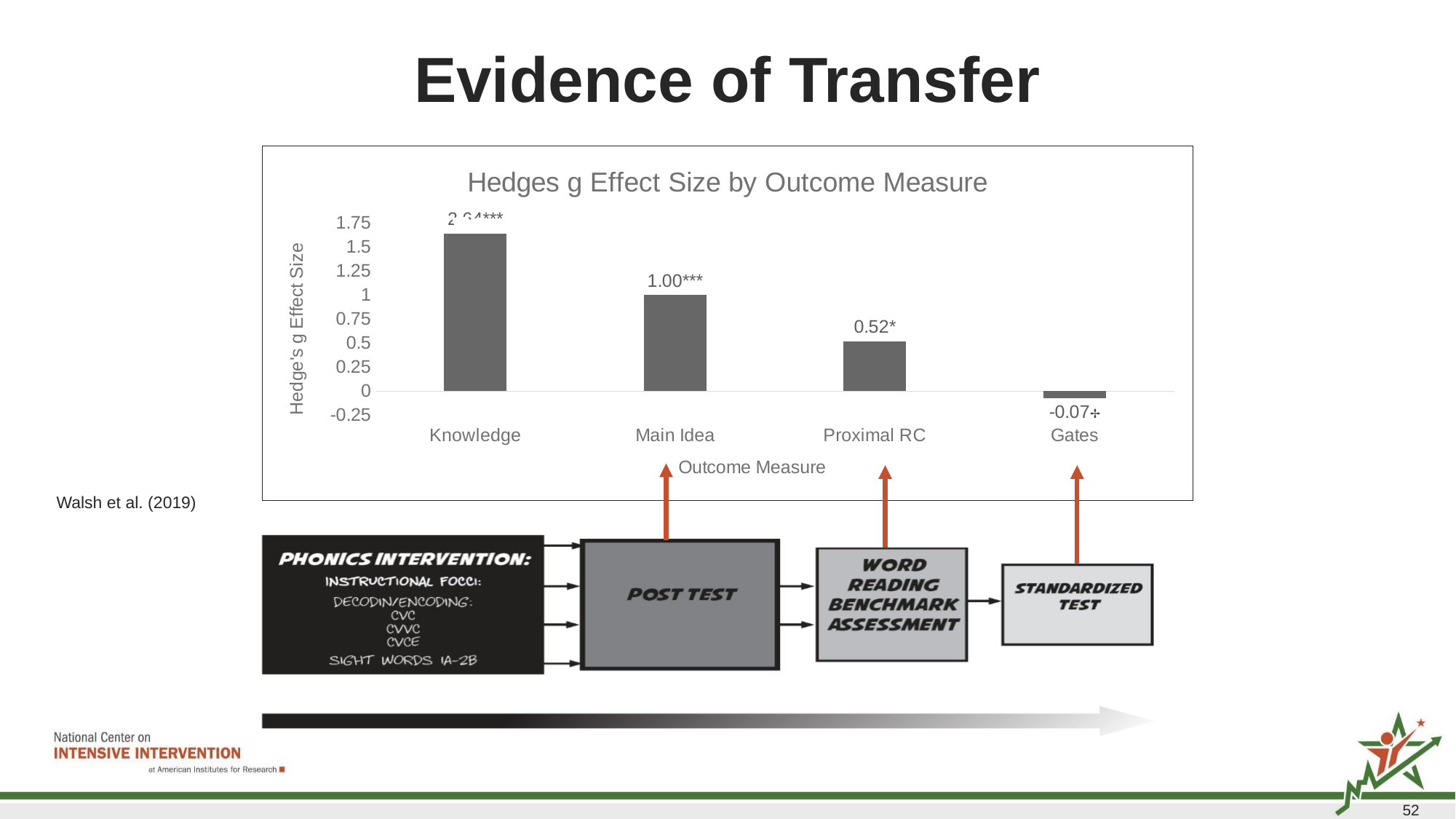
What is the Hedges g effect size for Proximal RC? 0.52* Which has a larger effect size, Main Idea or Proximal RC? Main Idea Which outcome measure has the highest effect size? Knowledge How many outcome measures are shown in the chart? 4 What is the title of the chart? Hedges g Effect Size by Outcome Measure What is the Hedges g effect size for Main Idea? 1.00*** Is the effect size for Knowledge greater or less than 1.5? greater What is the difference between the effect sizes for Main Idea and Proximal RC? 0.48 Do the effect sizes rise or fall from Knowledge to Gates along the x axis? fall Is the effect size for Gates greater or less than 0? less Which outcome measure has the lowest effect size? Gates What kind of chart is shown on the slide? bar chart